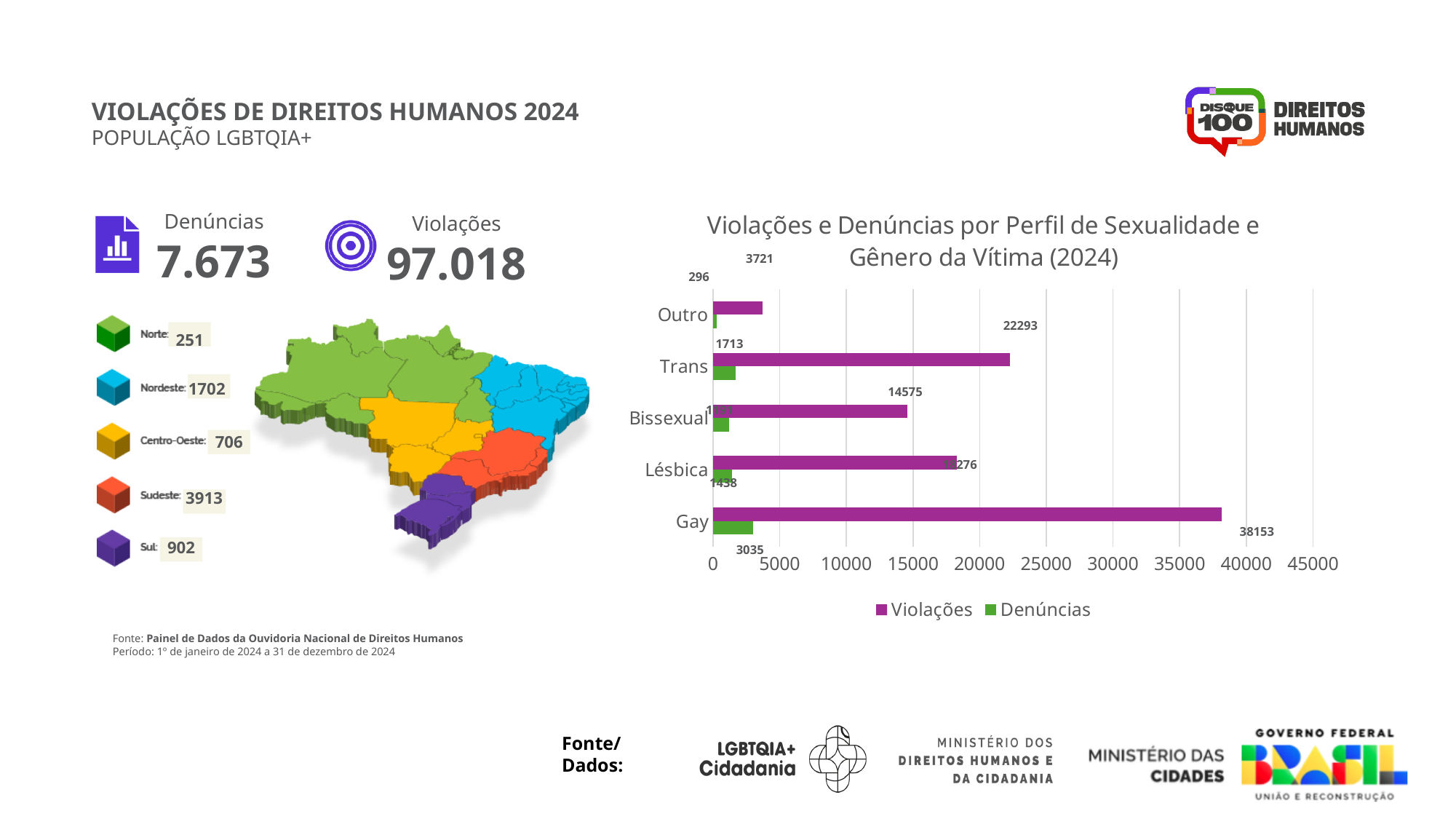
What is the Denúncias value for Gay? 3035 Which has a larger Violações value, Trans or Bissexual? Trans What is the Denúncias value for Outro? 296 Which category has the highest Violações value? Gay How many series does the legend of the chart list? 2 What is the Violações value for Gay? 38153 How many categories are shown on the chart's vertical axis? 5 Is the Violações value for Lésbica greater or less than 15000? greater What is the difference between the Violações values for Gay and Trans? 15860 What is the Violações value for Trans? 22293 What kind of chart is shown on the slide? bar chart Which category has the lowest Violações value? Outro